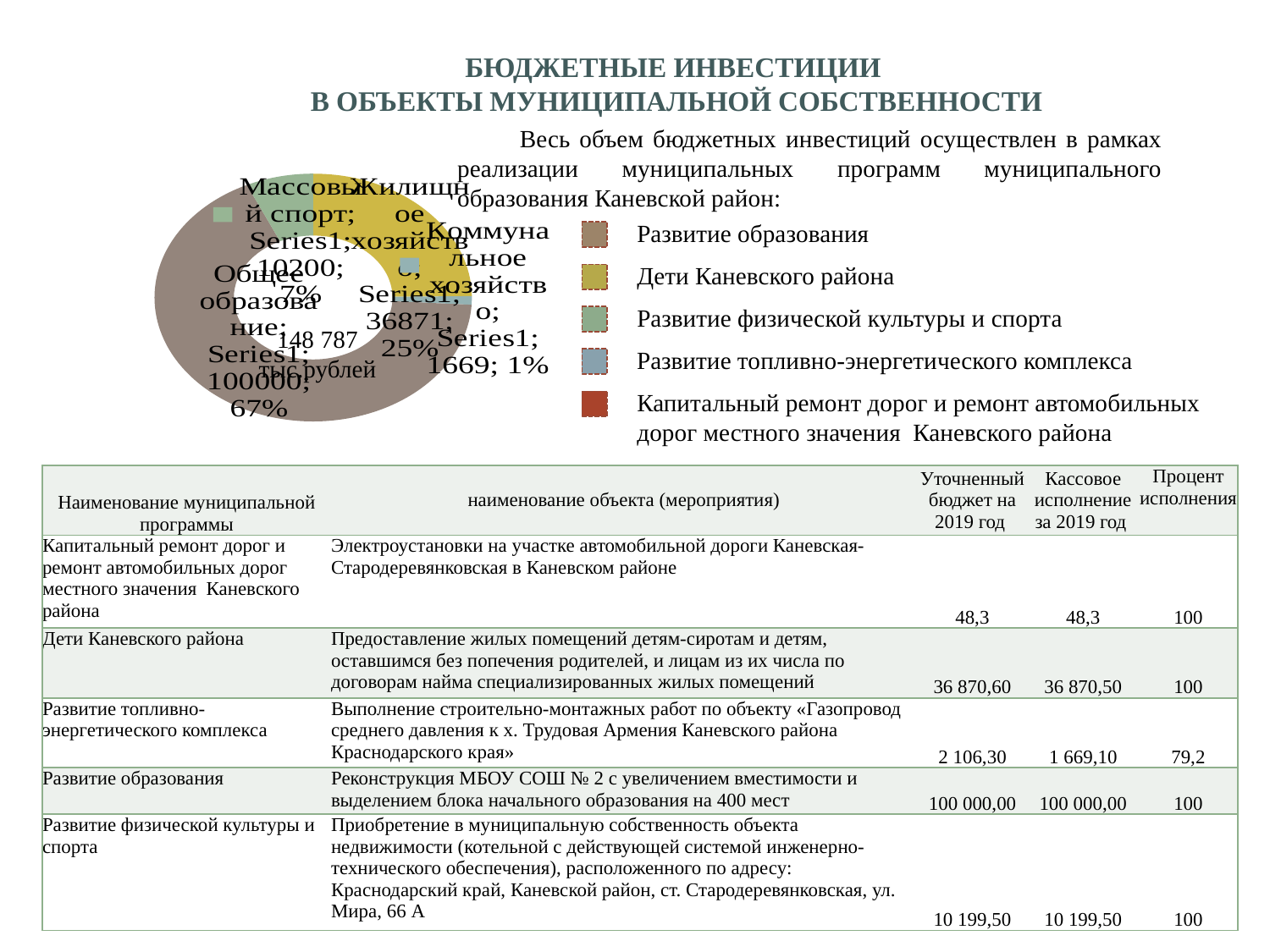
What share of the doughnut chart does Жилищное хозяйство represent? 25% What is the difference between the values for Общее образование and Жилищное хозяйство in the doughnut chart? 63129 What is the value for Массовый спорт in the doughnut chart? 10200 What is the value for Коммунальное хозяйство in the doughnut chart? 1669 What share of the doughnut chart does Общее образование represent? 67% Which category has the largest slice in the doughnut chart? Общее образование Which is larger in the doughnut chart, Жилищное хозяйство or Массовый спорт? Жилищное хозяйство What is the value for Жилищное хозяйство in the doughnut chart? 36871 What kind of chart is shown on the slide? doughnut (pie) chart What is the value for Общее образование in the doughnut chart? 100000